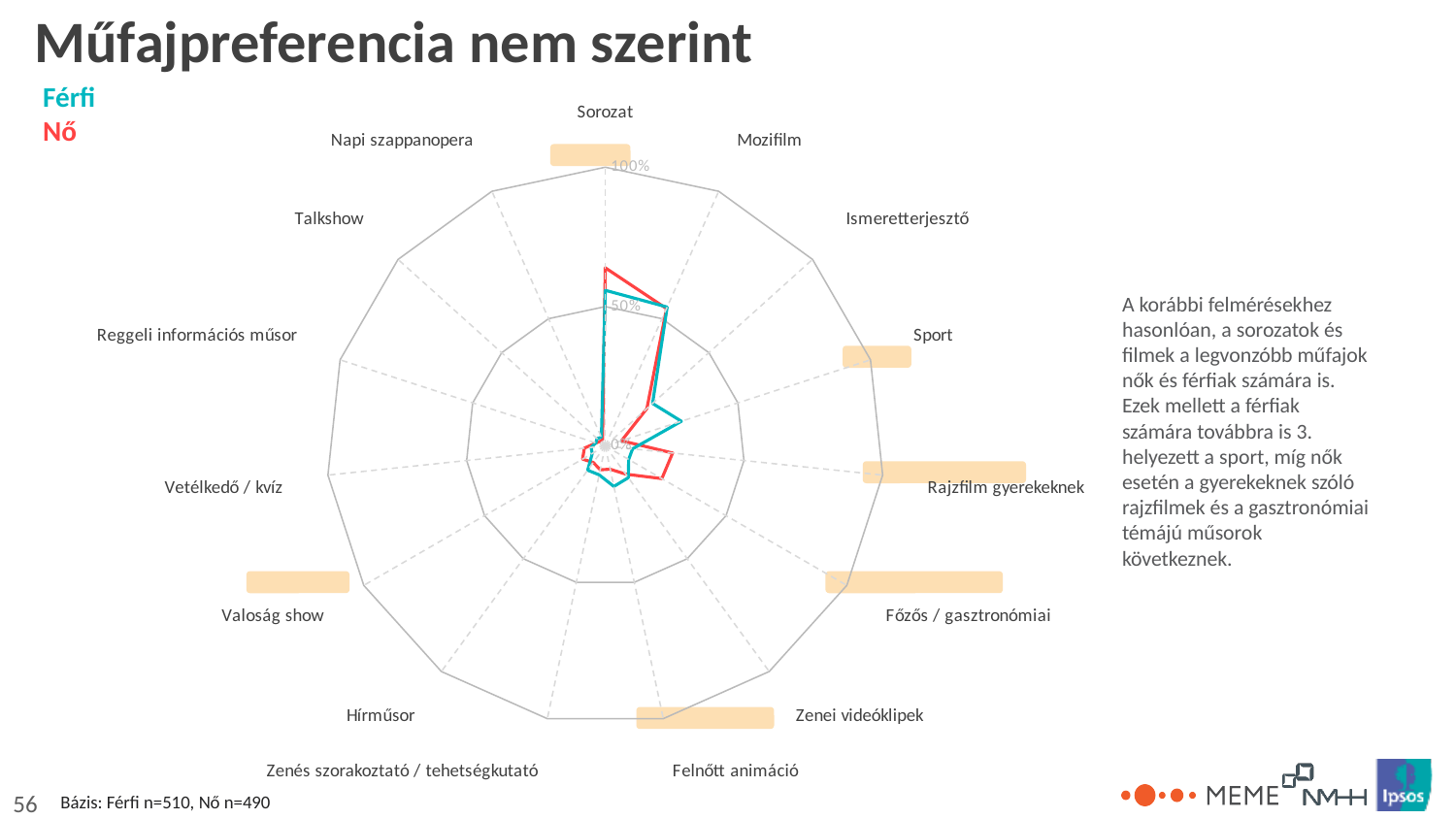
Which category has the highest value for the Nő series? Sorozat What colour is used for the Nő series? Red For Sport, which series has the larger value, Férfi or Nő? Férfi How many genre categories are plotted on the radar chart? 15 What kind of chart is shown on the slide? Radar chart How many series does the legend list? 2 For Főzős / gasztronómiai, which series has the larger value, Férfi or Nő? Nő Is the Férfi value for Talkshow greater or less than 50%? less Is the Nő value for Sorozat greater or less than 50%? greater For Rajzfilm gyerekeknek, which series has the larger value, Férfi or Nő? Nő Is the Férfi value for Sport greater or less than 50%? less